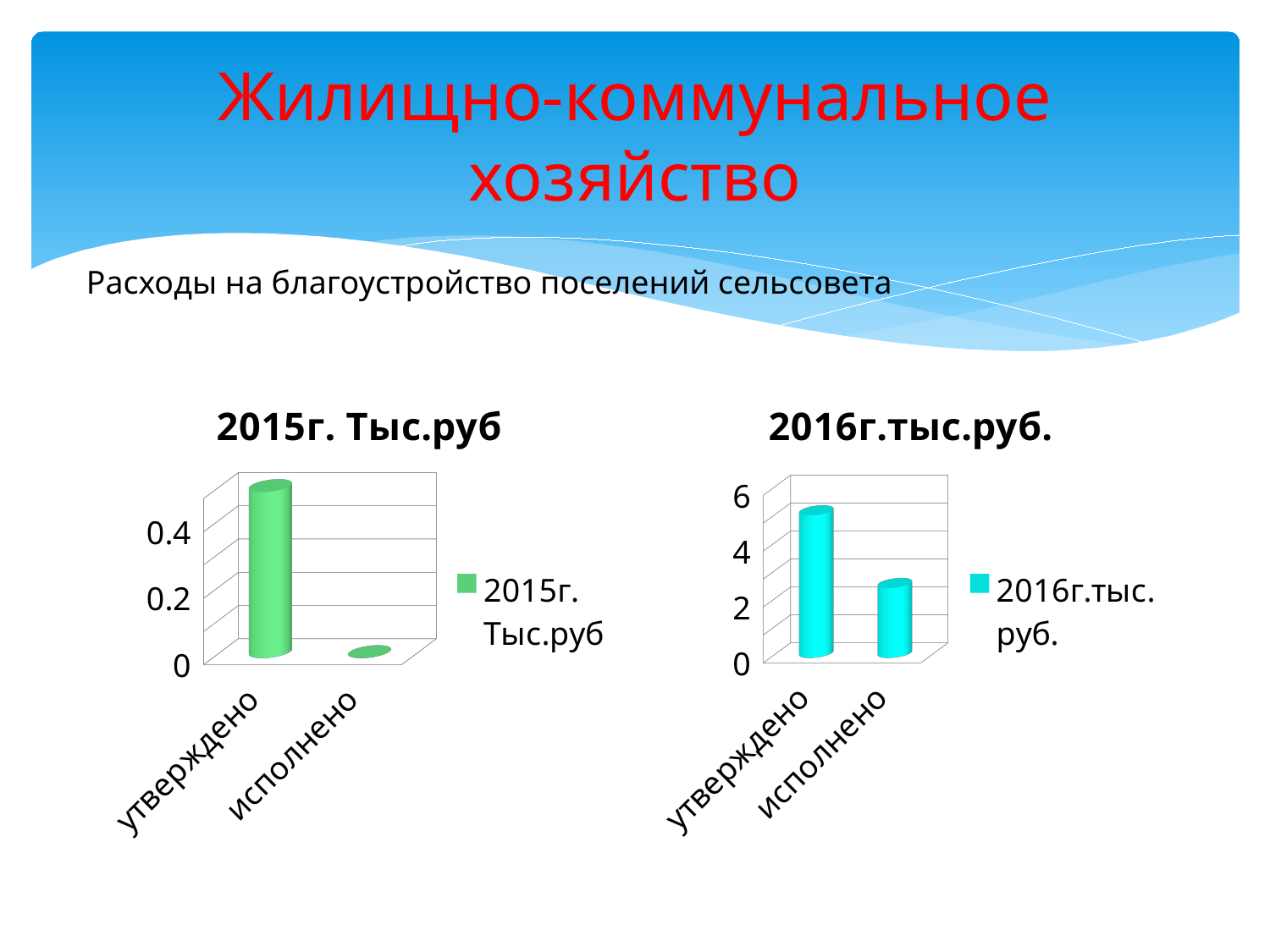
In the "2015г. Тыс.руб" chart, is the value for исполнено greater or less than 0.2? less In the "2016г.тыс.руб." chart, is the value for утверждено greater or less than 4? greater In the "2016г.тыс.руб." chart, which is larger: утверждено or исполнено? утверждено In the "2016г.тыс.руб." chart, how many series does the legend list? 1 In the "2015г. Тыс.руб" chart, how many categories are shown on the x axis? 2 In the "2016г.тыс.руб." chart, is the value for исполнено greater or less than 4? less What kind of chart is the "2016г.тыс.руб." chart? bar chart In the "2016г.тыс.руб." chart, which category has the lowest value? исполнено What kind of chart is the "2015г. Тыс.руб" chart? bar chart In the "2015г. Тыс.руб" chart, which category has the highest value? утверждено What is the legend entry of the "2016г.тыс.руб." chart? 2016г.тыс.руб.